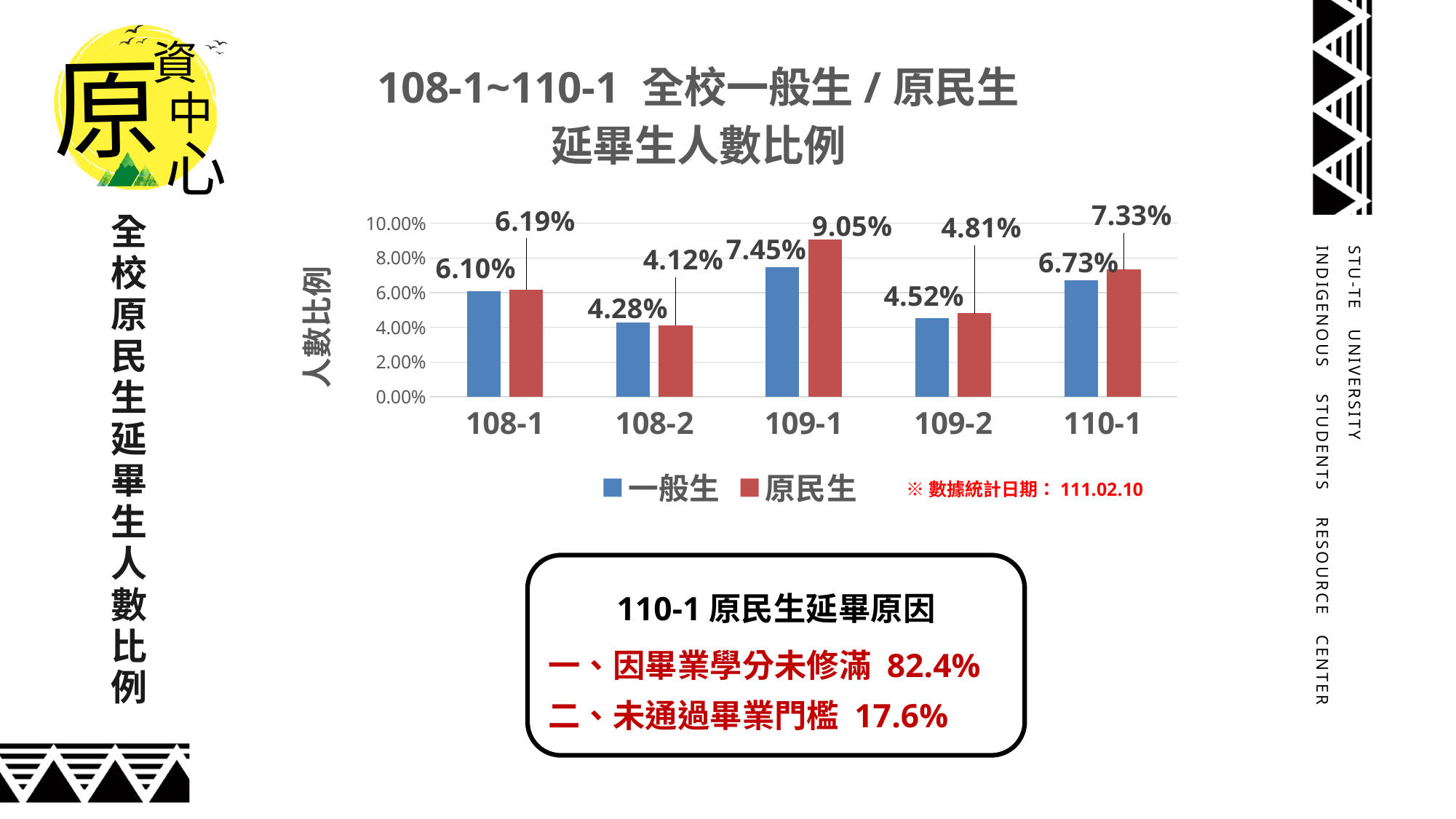
Is the value for 一般生 in 109-1 greater or less than 6.00%? greater What colour are the bars for 原民生? red What is the value for 一般生 in 108-2? 4.28% In which semester is the 一般生 value lowest? 108-2 What type of chart is shown on the slide? bar chart What is the difference between the 原民生 and 一般生 values in 109-1? 1.60% Which is larger in 108-2, the 一般生 value or the 原民生 value? 一般生 What is the value for 原民生 in 110-1? 7.33% How many semester categories are shown on the x axis? 5 What is the value for 原民生 in 109-1? 9.05% How many series does the legend list? 2 In which semester is the 原民生 value highest? 109-1